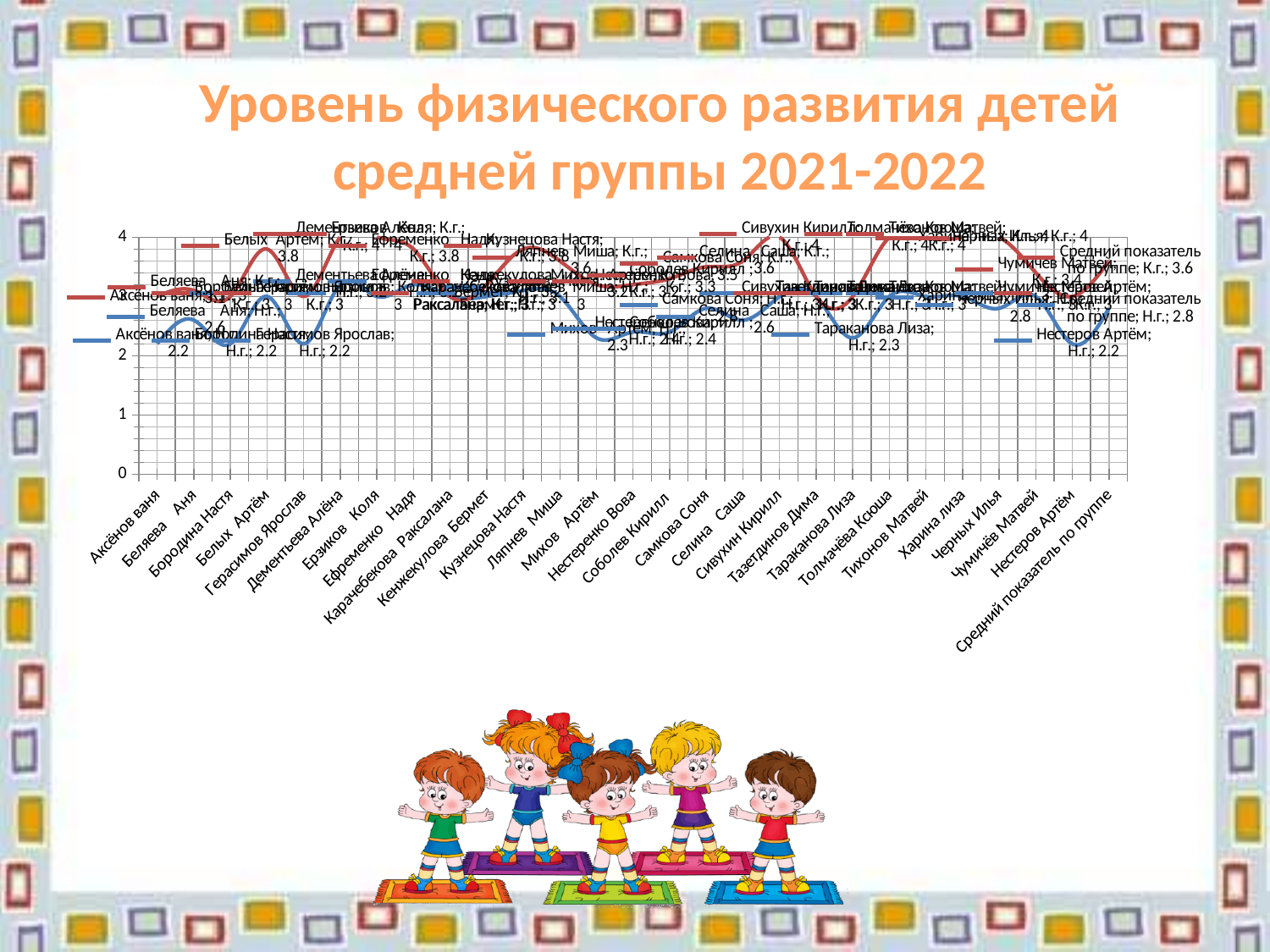
What is the title of the slide's chart? Уровень физического развития детей средней группы 2021-2022 What is the Н.г. value for Средний показатель по группе? 2.8 What is the Н.г. value for Тараканова Лиза? 2.3 Is the Н.г. value for Нестеров Артём greater or less than 3? less What is the К.г. value for Селина Саша? 3.6 What is the К.г. value for Чумичёв Матвей? 3.4 What is the Н.г. value for Аксёнов ваня? 2.2 What kind of chart is shown on the slide? line chart Which is larger, the К.г. value for Селина Саша or the К.г. value for Чумичёв Матвей? Селина Саша What is the difference between the К.г. and Н.г. values for Средний показатель по группе? 0.8 How many categories are listed along the x axis of the chart? 27 What is the К.г. value for Средний показатель по группе? 3.6